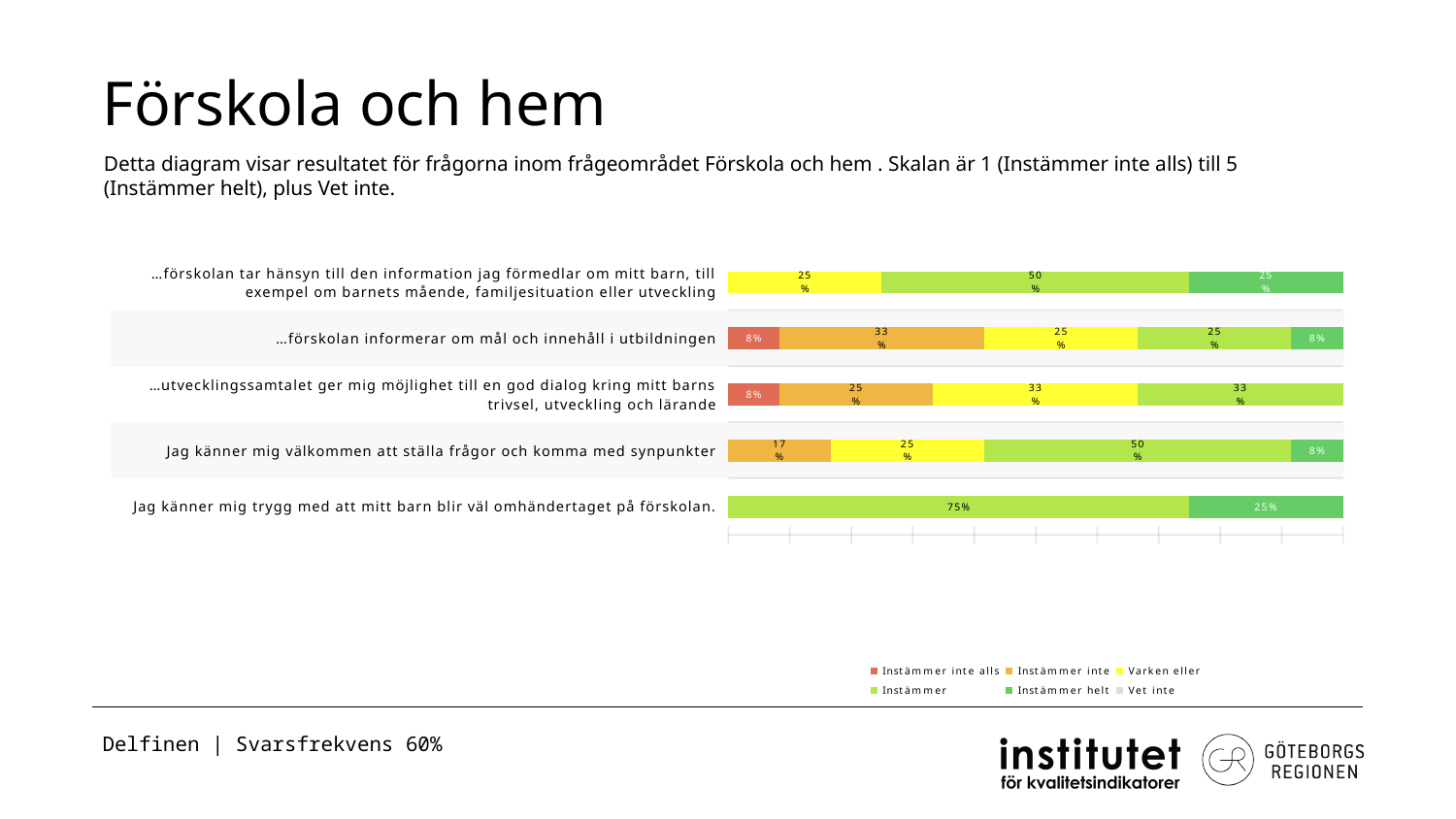
Which statement has the highest 'Instämmer' share? Jag känner mig trygg med att mitt barn blir väl omhändertaget på förskolan. How many series does the legend list? 6 What is the 'Varken eller' share for '…utvecklingssamtalet ger mig möjlighet till en god dialog kring mitt barns trivsel, utveckling och lärande'? 33% What is the 'Instämmer' share for 'Jag känner mig välkommen att ställa frågor och komma med synpunkter'? 50% What is the 'Instämmer inte' share for '…förskolan informerar om mål och innehåll i utbildningen'? 33% What is the difference between the 'Instämmer' share for 'Jag känner mig trygg med att mitt barn blir väl omhändertaget på förskolan.' and the 'Instämmer' share for '…förskolan informerar om mål och innehåll i utbildningen'? 50 percentage points What is the 'Instämmer inte alls' share for '…utvecklingssamtalet ger mig möjlighet till en god dialog kring mitt barns trivsel, utveckling och lärande'? 8% Which legend entry is shown in red? Instämmer inte alls Which is larger: the 'Instämmer helt' share for '…förskolan tar hänsyn till den information jag förmedlar om mitt barn…' or for '…förskolan informerar om mål och innehåll i utbildningen'? …förskolan tar hänsyn till den information jag förmedlar om mitt barn… What kind of chart is shown on the slide? Stacked bar chart How many statements (categories) are plotted in the chart? 5 What is the 'Instämmer' share for 'Jag känner mig trygg med att mitt barn blir väl omhändertaget på förskolan.'? 75%